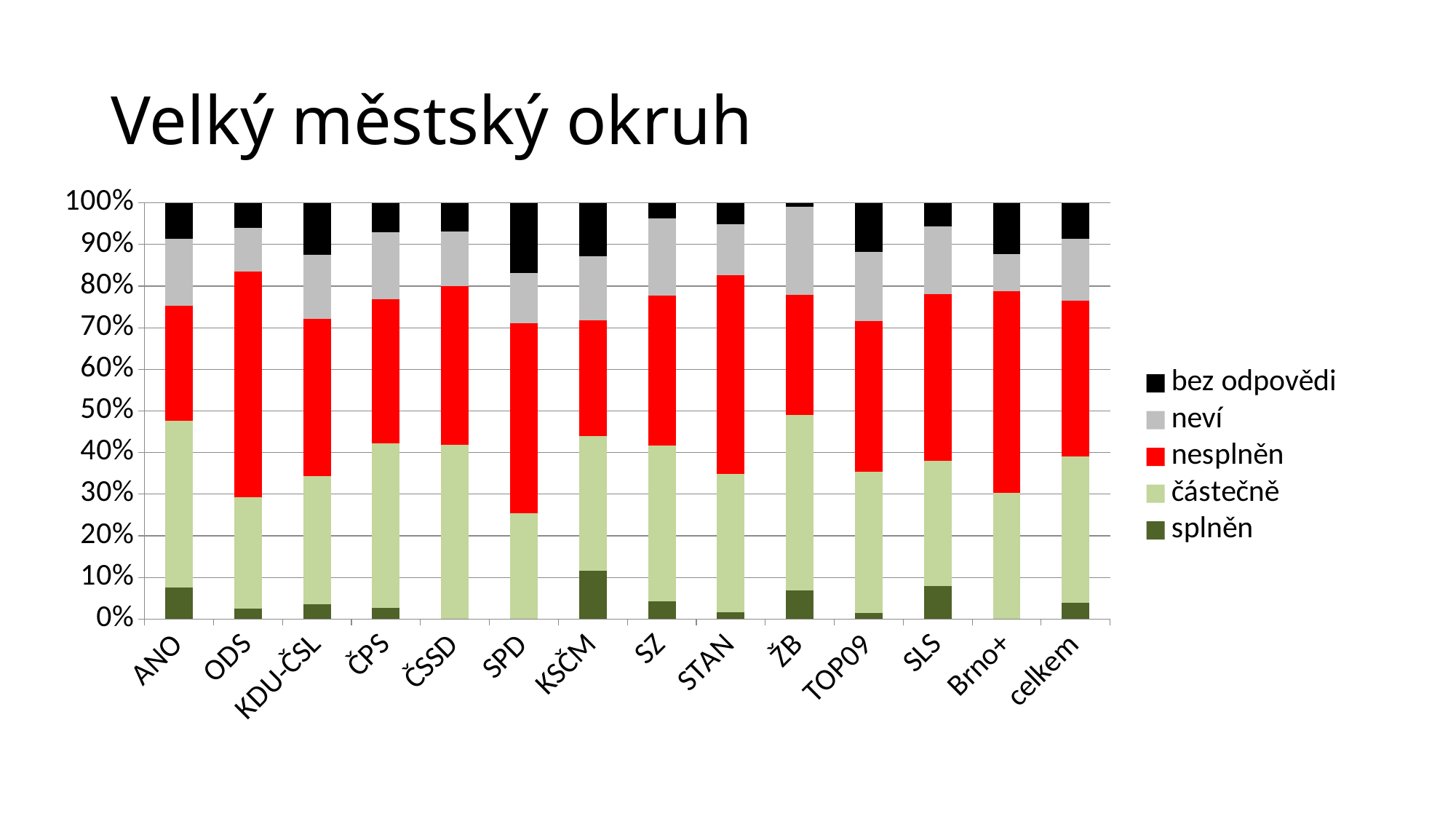
Which category has the largest splněn share? KSČM Which legend entry is shown in red? nesplněn What is the title of the slide? Velký městský okruh Is the splněn value for KSČM greater or less than 10%? greater Which has a larger nesplněn share, ODS or ANO? ODS How many series does the legend list? 5 Is the splněn value for ANO greater or less than 10%? less Which category has the largest bez odpovědi share? SPD How many categories are shown along the x axis of the chart? 14 What kind of chart is shown on the slide? stacked bar chart Which category has the largest nesplněn share? ODS Which category has the smallest bez odpovědi share? ŽB